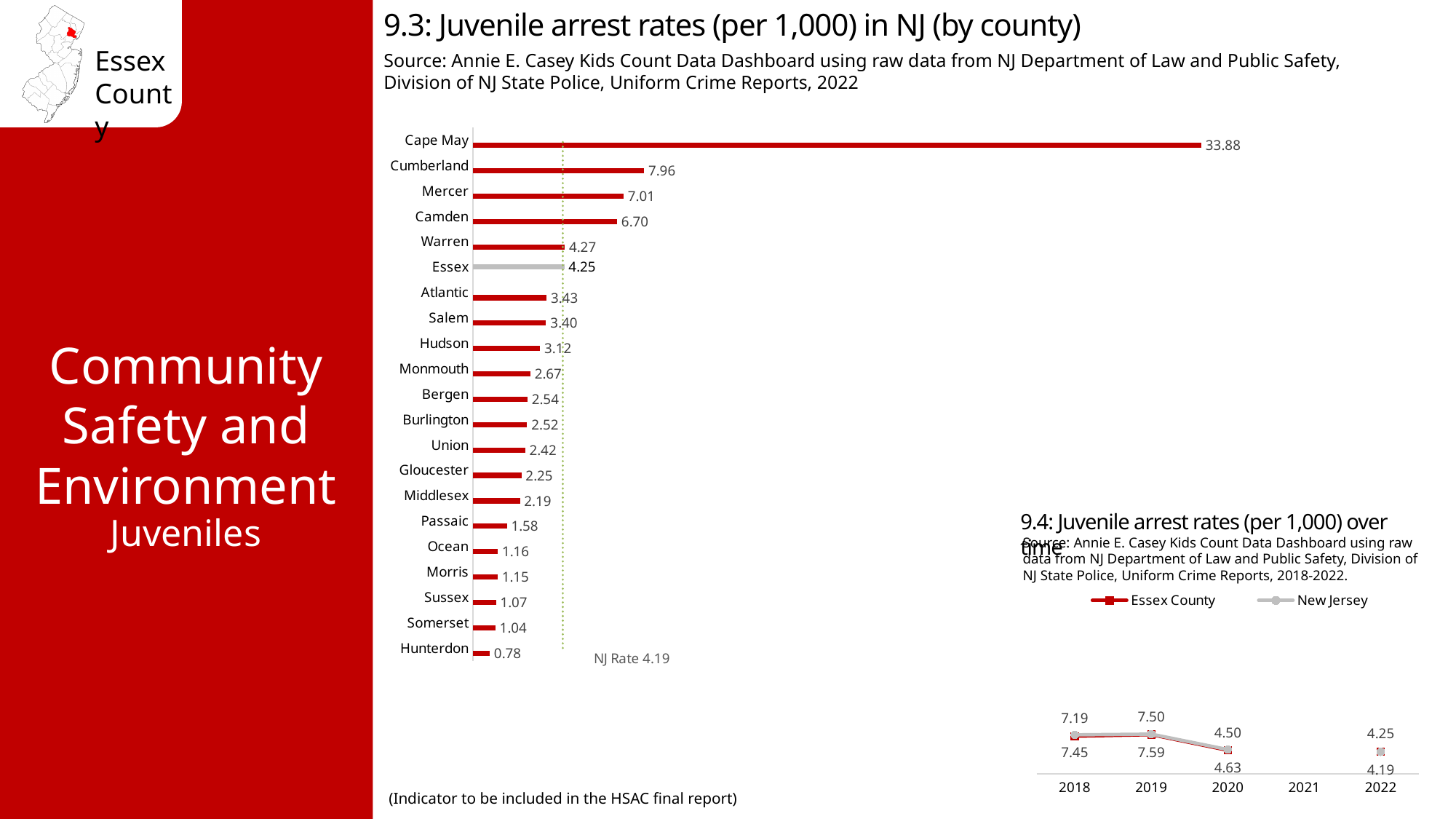
In the chart '9.4: Juvenile arrest rates (per 1,000) over time', what is the Essex County rate in 2022? 4.25 In the chart '9.3: Juvenile arrest rates (per 1,000) in NJ (by county)', which county has a higher rate, Camden or Warren? Camden In the chart '9.4: Juvenile arrest rates (per 1,000) over time', how many series does the legend list? 2 In the chart '9.3: Juvenile arrest rates (per 1,000) in NJ (by county)', which county has the highest juvenile arrest rate? Cape May In the chart '9.3: Juvenile arrest rates (per 1,000) in NJ (by county)', what is the difference between the rates for Cumberland and Mercer? 0.95 What kind of chart is '9.3: Juvenile arrest rates (per 1,000) in NJ (by county)'? Bar chart In the chart '9.3: Juvenile arrest rates (per 1,000) in NJ (by county)', how many counties are shown? 21 In the chart '9.3: Juvenile arrest rates (per 1,000) in NJ (by county)', what is the juvenile arrest rate for Essex? 4.25 In the chart '9.3: Juvenile arrest rates (per 1,000) in NJ (by county)', what NJ rate is marked by the dotted reference line? 4.19 In the chart '9.4: Juvenile arrest rates (per 1,000) over time', what is the New Jersey rate in 2022? 4.19 In the chart '9.3: Juvenile arrest rates (per 1,000) in NJ (by county)', which county has the lowest juvenile arrest rate? Hunterdon In the chart '9.3: Juvenile arrest rates (per 1,000) in NJ (by county)', what is the juvenile arrest rate for Cape May? 33.88